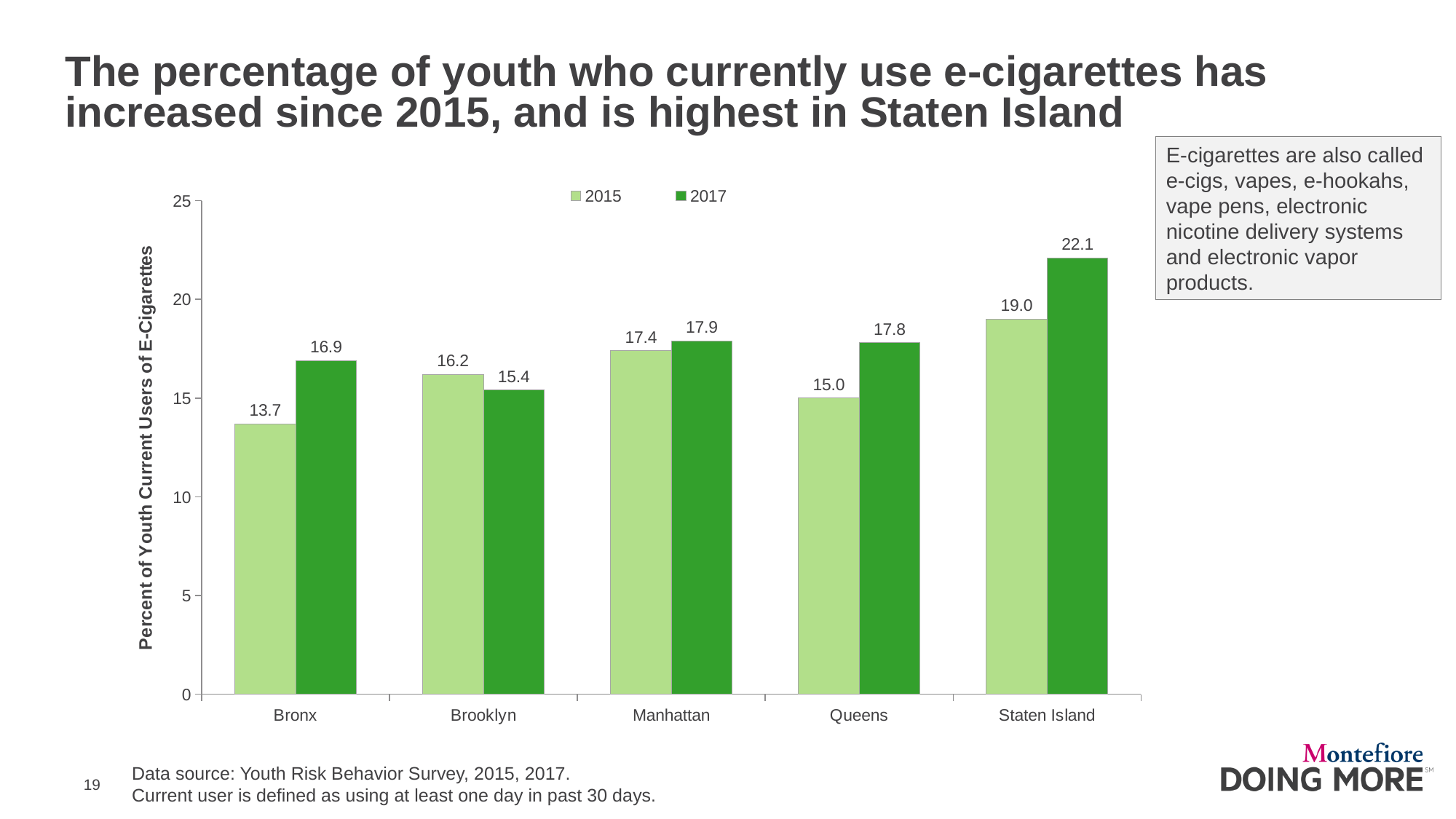
How many boroughs are shown on the x axis? 5 Is the 2017 value for Staten Island greater or less than 20? greater What is the difference between the 2017 and 2015 values for the Bronx? 3.2 What is the 2017 value for Staten Island? 22.1 What is the 2015 value for the Bronx? 13.7 What kind of chart is shown on the slide? bar chart Which borough has the lowest 2015 value? Bronx What is the 2017 value for Brooklyn? 15.4 What is the difference between the 2015 and 2017 values for Brooklyn? 0.8 How many series does the legend list? 2 Which is larger for Queens, the 2015 value or the 2017 value? 2017 Which borough has the highest 2017 value? Staten Island